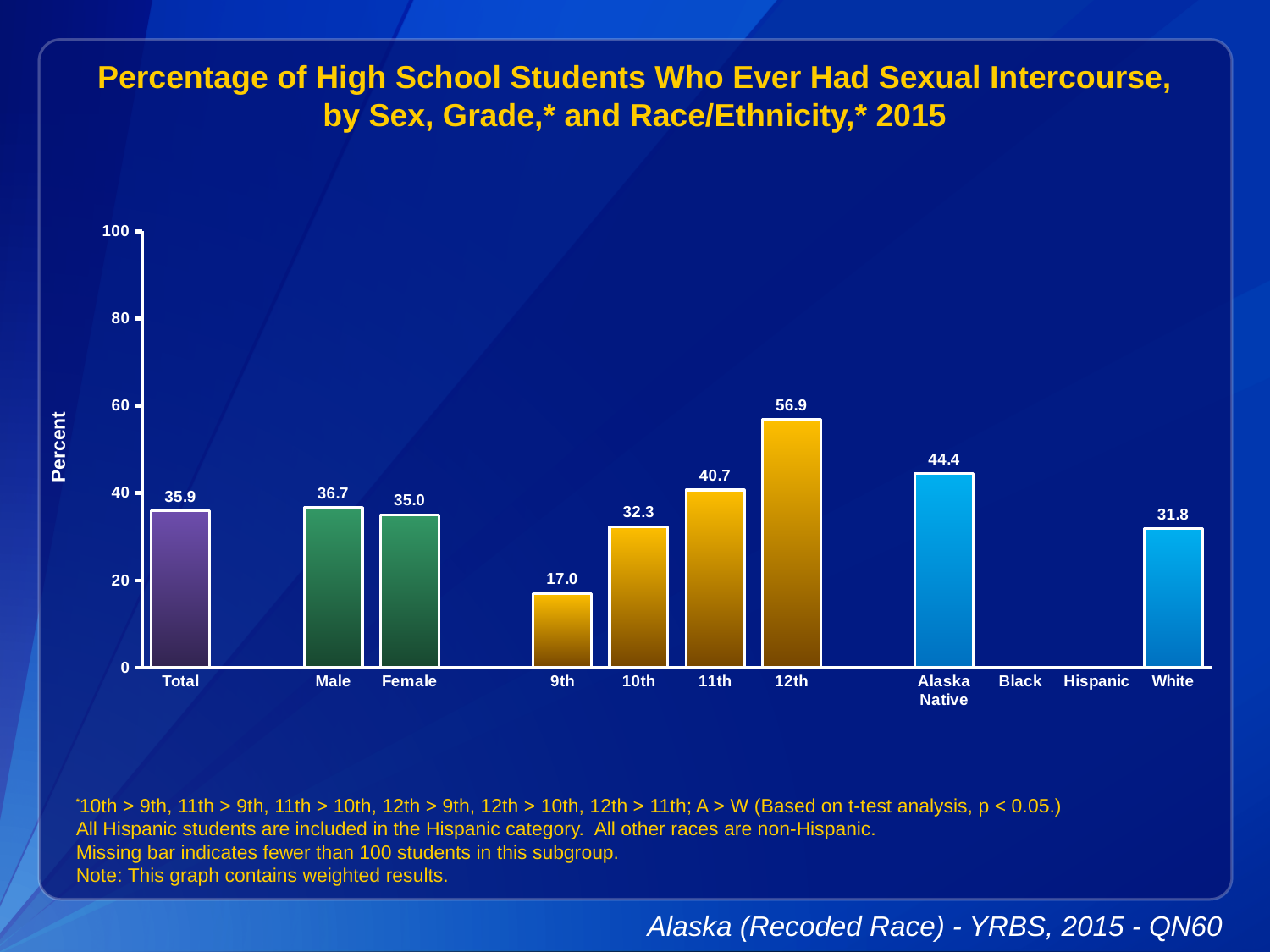
Is the value for 11th grade greater or less than 40? greater Do the values rise or fall from 9th grade to 12th grade? rise Which category has the lowest plotted value? 9th What is the value for Alaska Native? 44.4 What kind of chart is shown? bar chart What is the difference between the Male and Female values? 1.7 Which is larger, the value for Alaska Native or the value for White? Alaska Native How many bars are plotted on the chart? 9 What is the value for Total? 35.9 What is the value for 12th grade? 56.9 What is the difference between the 12th and 9th grade values? 39.9 Which category has the highest value? 12th